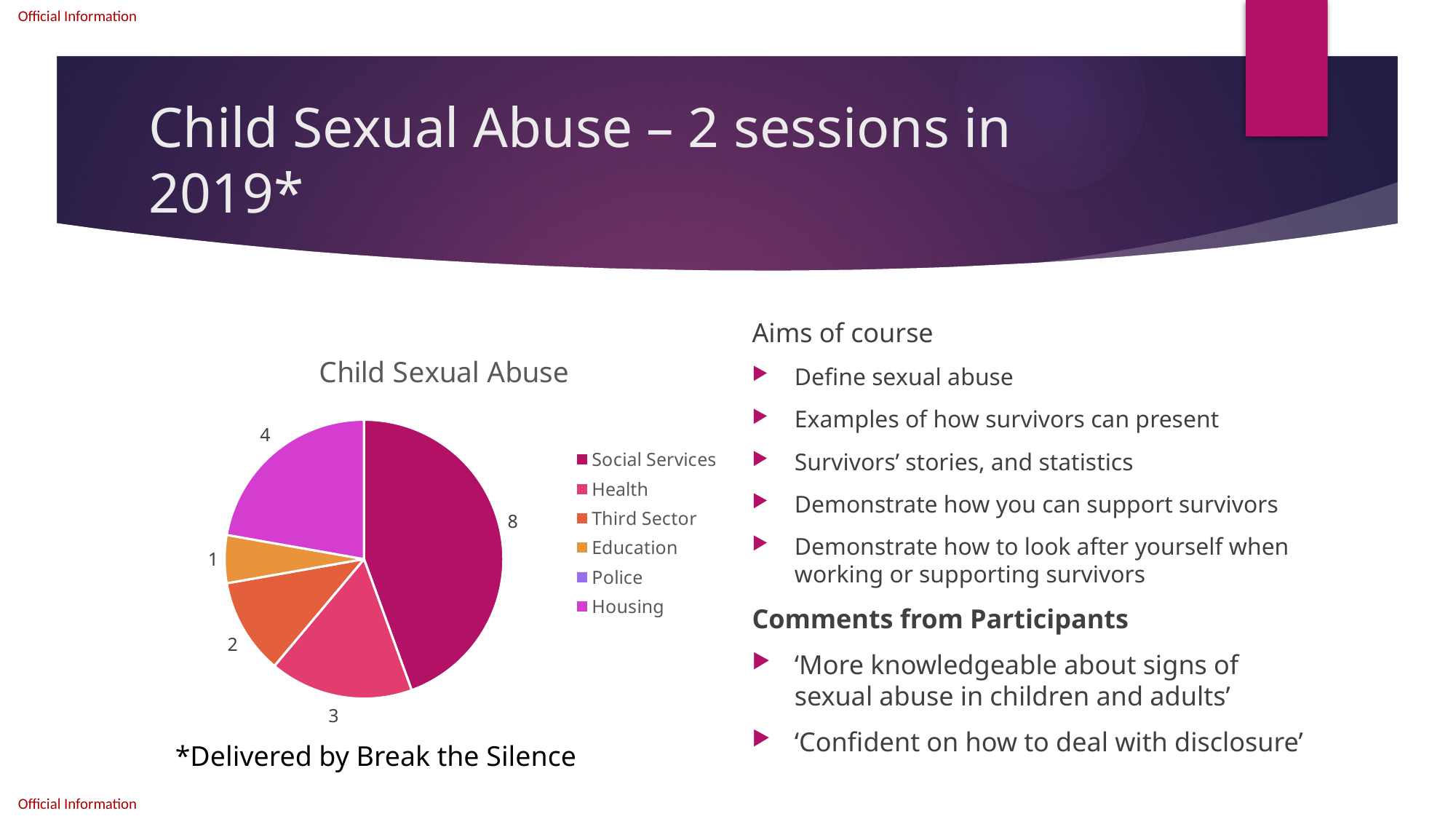
What is the title of the chart? Child Sexual Abuse Which is larger, the value for Housing or the value for Health? Housing What is the value for Third Sector in the pie chart? 2 What type of chart is shown on the slide? pie chart What is the value for Health in the pie chart? 3 Which category has the largest slice of the pie chart? Social Services What is the value for Social Services in the pie chart? 8 How many slices with data labels are shown in the pie chart? 5 What is the value for Housing in the pie chart? 4 What is the difference between the values for Social Services and Housing? 4 Which labelled slice of the pie chart has the smallest value? Education How many entries does the chart legend list? 6